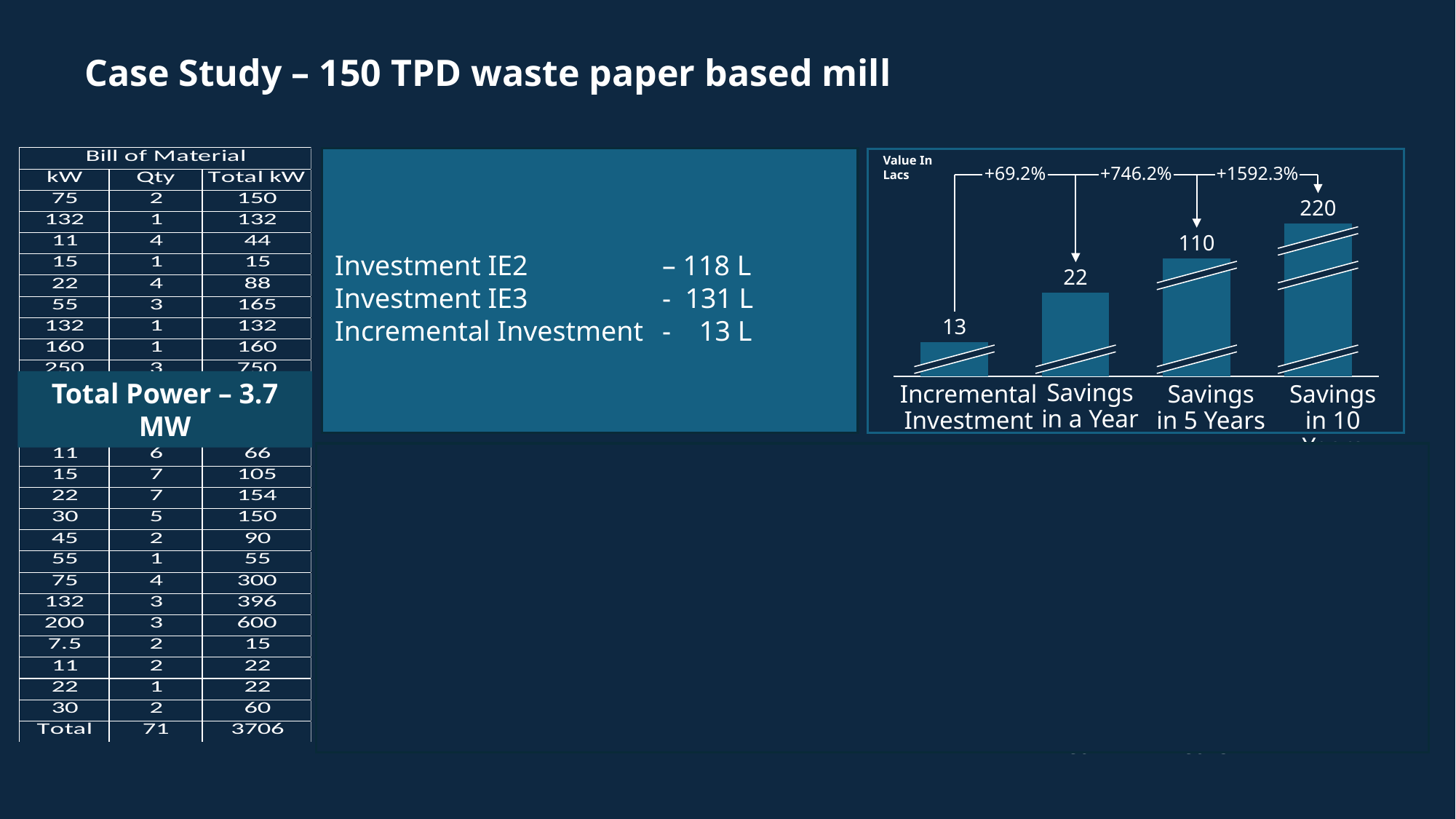
Which category has the lowest value on the chart? Incremental Investment What is the difference between Savings in 10 Years and Savings in 5 Years? 110 What is the difference between Savings in a Year and Incremental Investment? 9 What is the value for Savings in 5 Years on the chart? 110 What kind of chart is shown on the slide? Bar chart What is the value for Incremental Investment on the chart? 13 Which is larger, Savings in a Year or Savings in 5 Years? Savings in 5 Years What is the value for Savings in a Year on the chart? 22 Do the values rise or fall from left to right across the chart? Rise Which category has the highest value on the chart? Savings in 10 Years How many categories are shown on the chart? 4